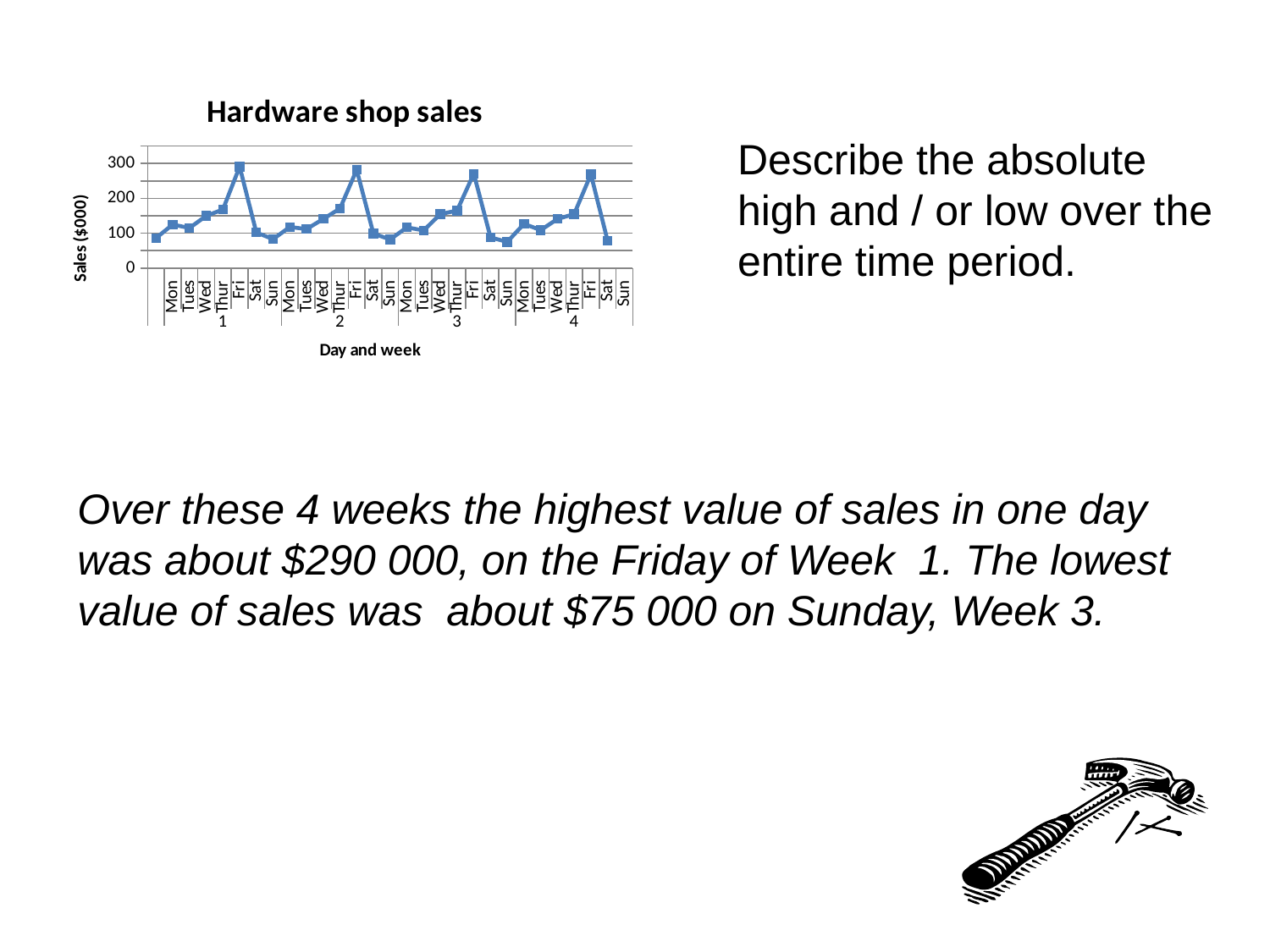
Is the value for Friday of Week 1 greater or less than 200? greater What is the label on the vertical axis of the chart? Sales ($000) Which is larger, the value for Friday of Week 2 or the value for Saturday of Week 2? Friday of Week 2 How many weeks are shown along the x axis of the chart? 4 What is the title of the chart? Hardware shop sales Is the value for Sunday of Week 3 greater or less than 100? less On which day and week does the chart reach its lowest value? Sunday, Week 3 How many data points are plotted on the chart? 28 What kind of chart is shown on the slide? Line chart Is the value for Saturday of Week 4 greater or less than 100? less On which day and week does the chart reach its highest value? Friday, Week 1 Within each week, do sales rise or fall from Monday to Friday? Rise